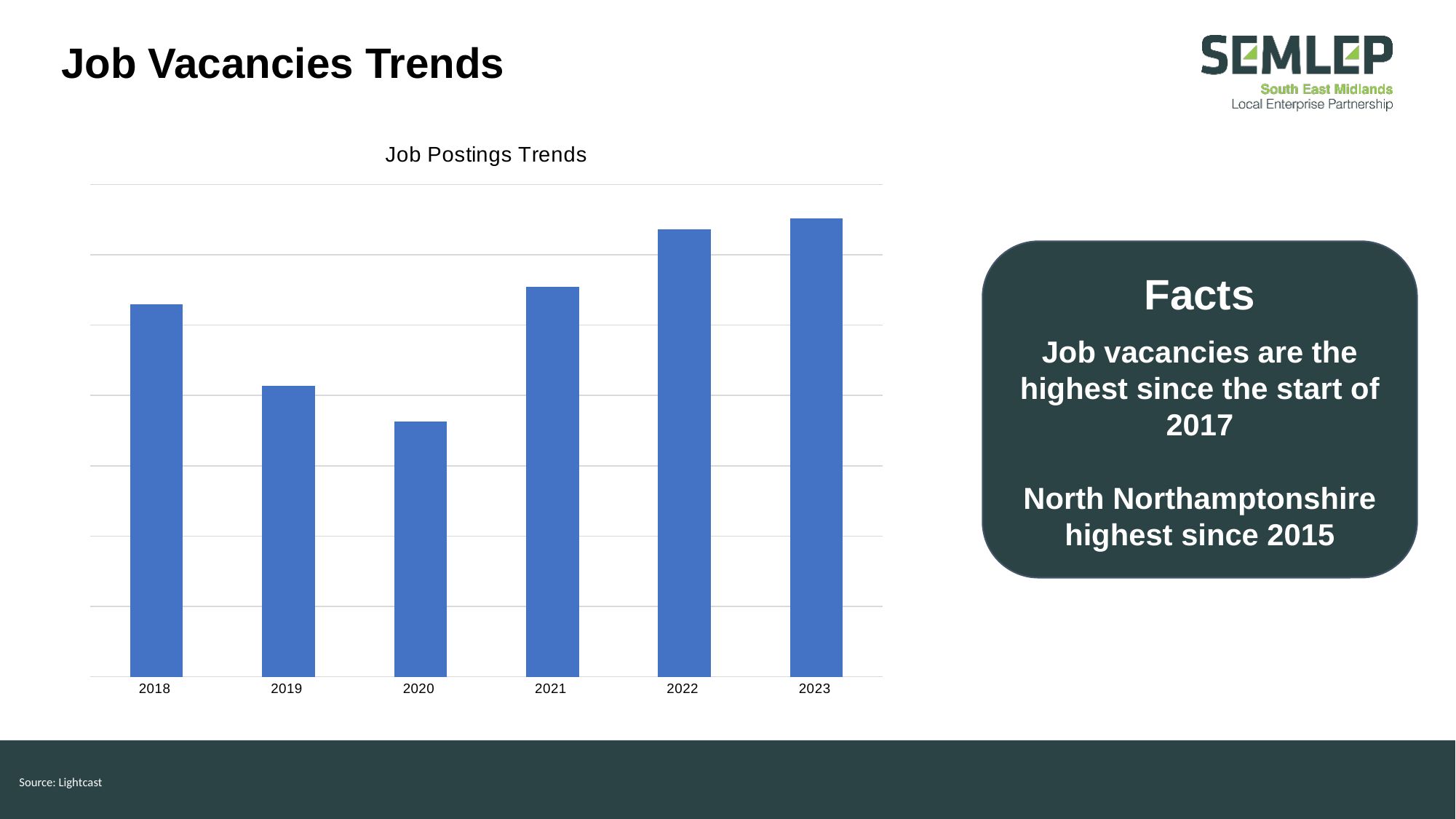
Do the values rise or fall from 2018 to 2020? Fall What is the first year shown on the x axis of the chart? 2018 Which year has the highest bar in the chart? 2023 Which year has the higher value, 2018 or 2019? 2018 Which year has the higher value, 2020 or 2022? 2022 Which year has the higher value, 2018 or 2021? 2021 Which year has the lowest bar in the chart? 2020 Do the values rise or fall from 2020 to 2023? Rise How many years are shown on the x axis of the chart? 6 What type of chart is shown on the slide? Bar chart What is the title of the chart? Job Postings Trends